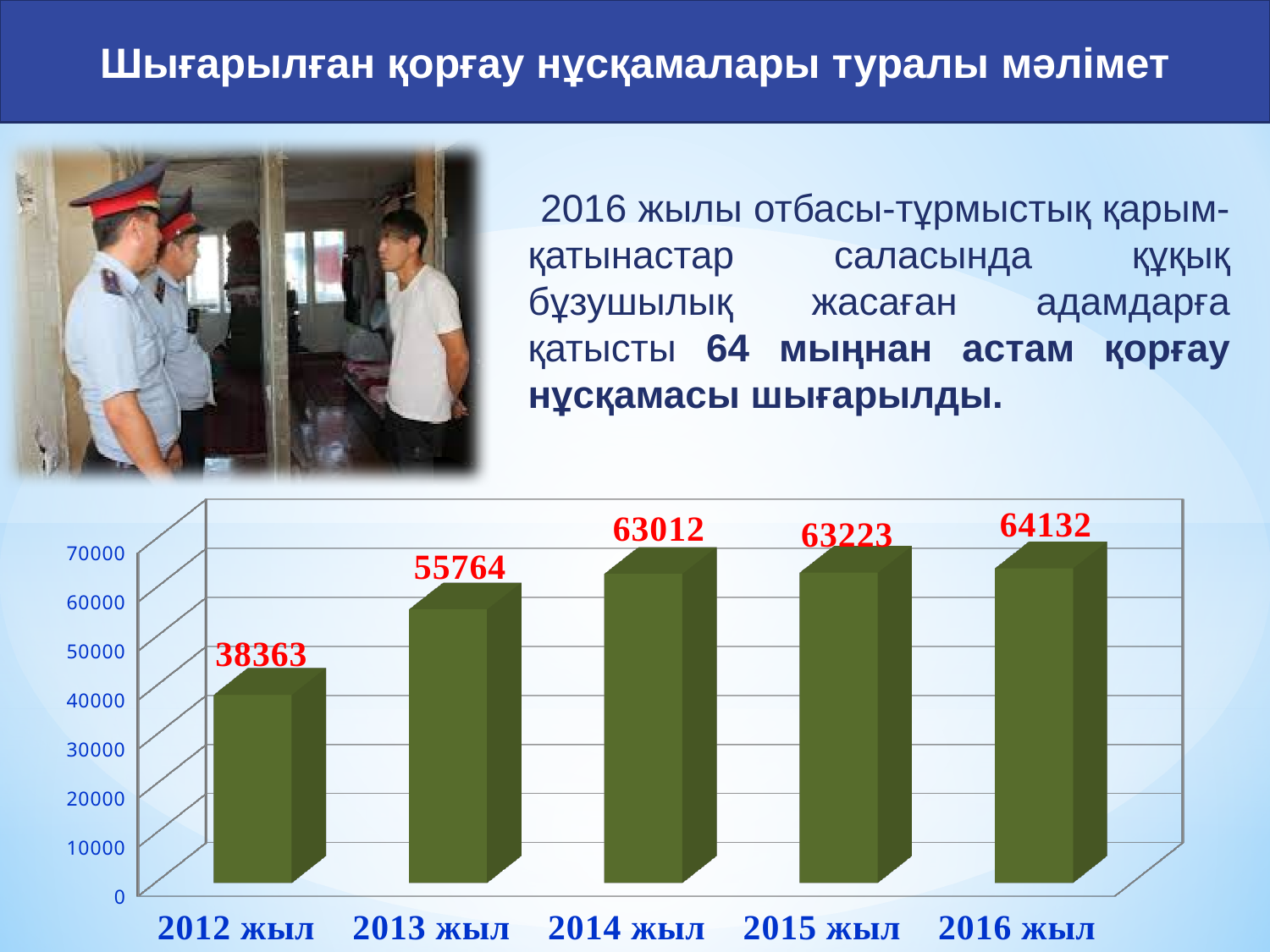
Which year has the lowest value? 2012 жыл Which year has the highest value? 2016 жыл What is the value for 2012 жыл? 38363 Which is larger, the value for 2013 жыл or the value for 2014 жыл? 2014 жыл What is the difference between the values for 2016 жыл and 2015 жыл? 909 What is the value for 2016 жыл? 64132 How many years are shown on the chart? 5 What is the difference between the values for 2013 жыл and 2012 жыл? 17401 What is the value for 2014 жыл? 63012 Do the values rise or fall from 2012 жыл to 2016 жыл? rise What kind of chart is shown on the slide? bar chart Is the value for 2012 жыл greater or less than 40000? less